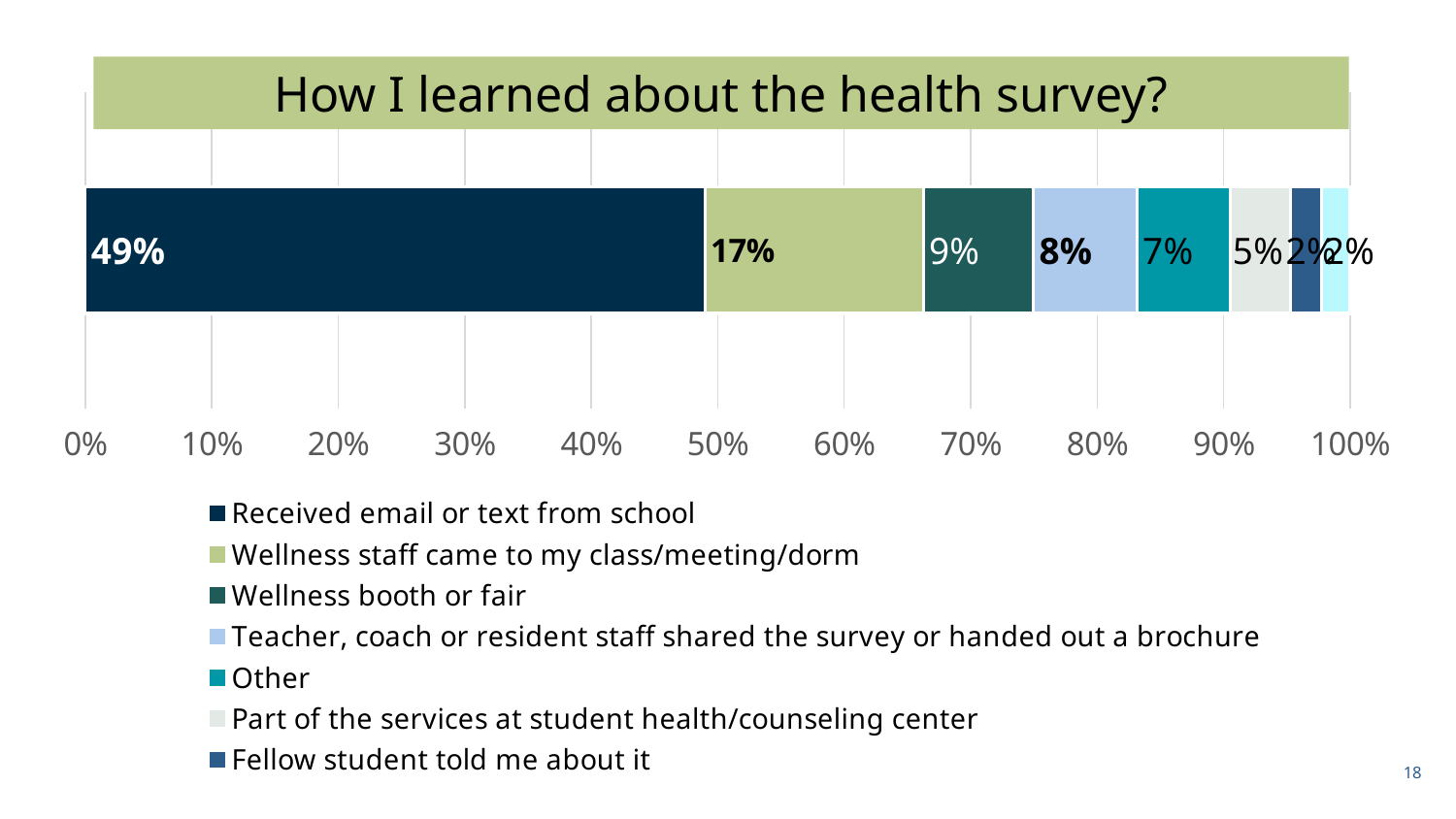
What percentage is shown for 'Other'? 7% Which is larger: the value for 'Wellness booth or fair' or the value for 'Other'? Wellness booth or fair What is the value for 'Part of the services at student health/counseling center'? 5% What kind of chart is shown on the slide? Stacked bar chart What is the value for 'Teacher, coach or resident staff shared the survey or handed out a brochure'? 8% What is the value for 'Wellness staff came to my class/meeting/dorm'? 17% Which way of learning about the health survey has the highest percentage? Received email or text from school What is the title of the chart? How I learned about the health survey? How many entries does the legend list? 7 What is the difference in percentage points between 'Received email or text from school' and 'Wellness staff came to my class/meeting/dorm'? 32 What percentage of respondents learned about the health survey by receiving an email or text from school? 49% What percentage learned about the survey from a wellness booth or fair? 9%